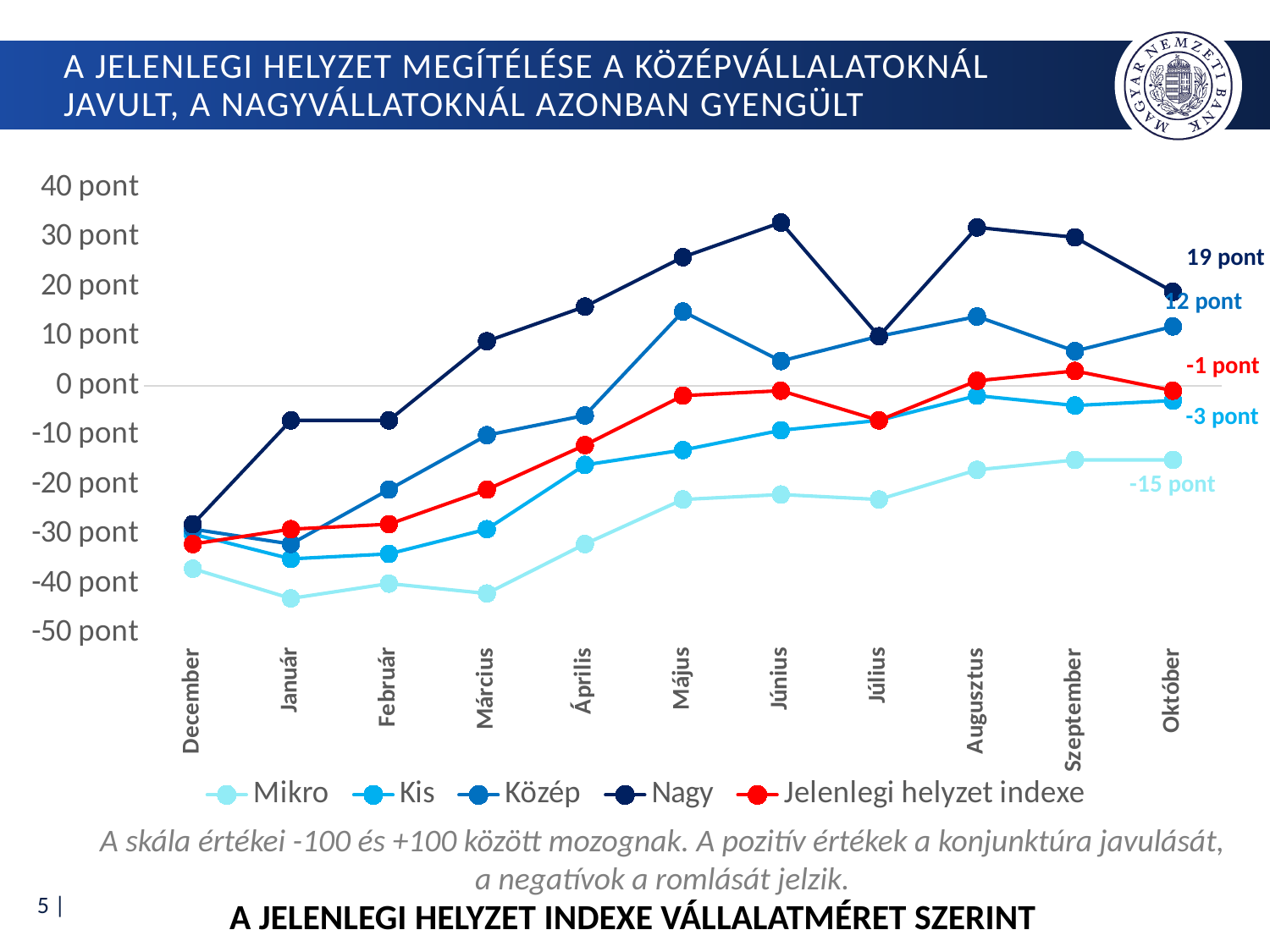
Which series has the lowest value in Október? Mikro What is the value of the Nagy series in Október? 19 pont Which series has the highest value in Október? Nagy Is the value for Nagy in Június greater or less than 30 pont? greater What is the value of the Közép series in Október? 12 pont What is the value of the Mikro series in Október? -15 pont What kind of chart is shown on the slide? line chart Is the value for Mikro in Január greater or less than -40 pont? less What is the difference between the Nagy and Közép values in Október? 7 pont What is the value of the Jelenlegi helyzet indexe series in Október? -1 pont How many series does the legend list? 5 How many months are shown on the x axis? 11